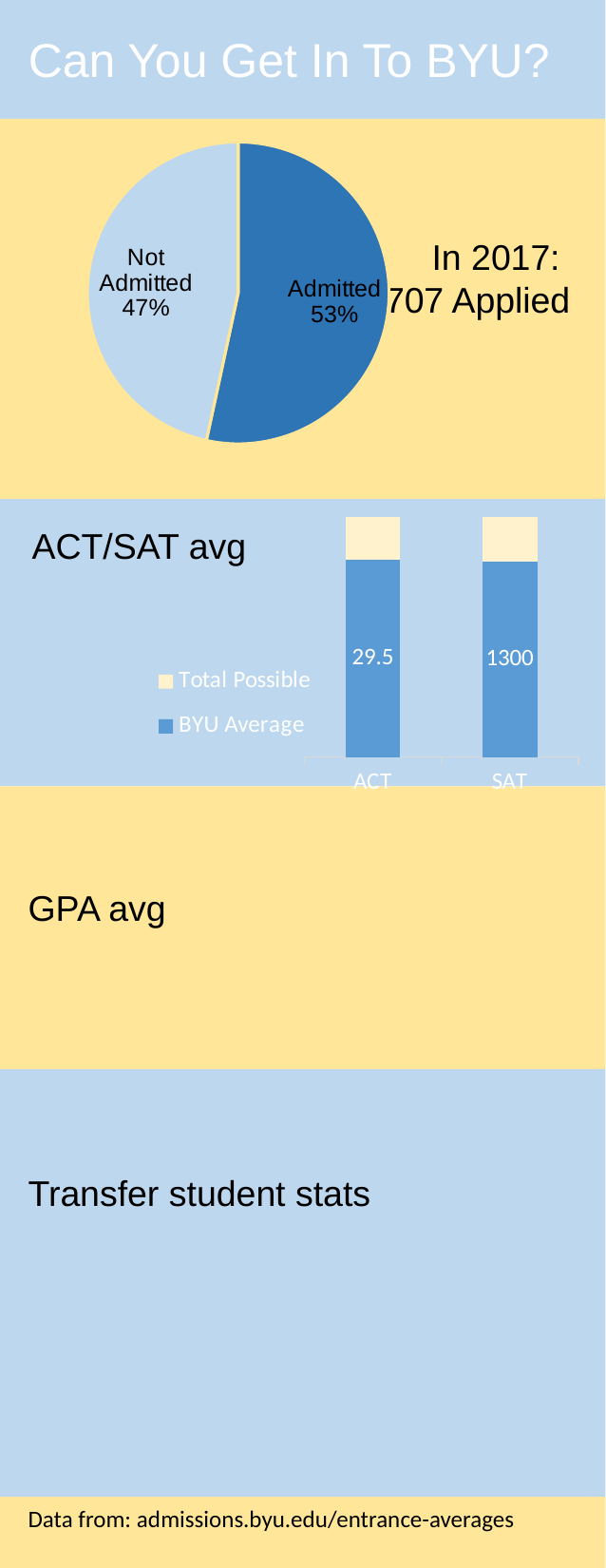
In the pie chart, what percentage of applicants were Not Admitted? 47% In the ACT/SAT avg chart, what is the BYU Average value for ACT? 29.5 How many series does the legend of the ACT/SAT avg chart list? 2 What kind of chart is the ACT/SAT avg chart? Bar chart What kind of chart is the chart at the top of the slide showing Admitted and Not Admitted? Pie chart How many slices does the pie chart have? 2 How many categories are shown on the x axis of the ACT/SAT avg chart? 2 In the ACT/SAT avg chart, what is the BYU Average value for SAT? 1300 In the pie chart, what percentage of applicants were Admitted? 53% What are the two legend entries in the ACT/SAT avg chart? Total Possible and BYU Average In the pie chart, by how many percentage points does the Admitted share exceed the Not Admitted share? 6 percentage points In the pie chart, which slice is larger, Admitted or Not Admitted? Admitted